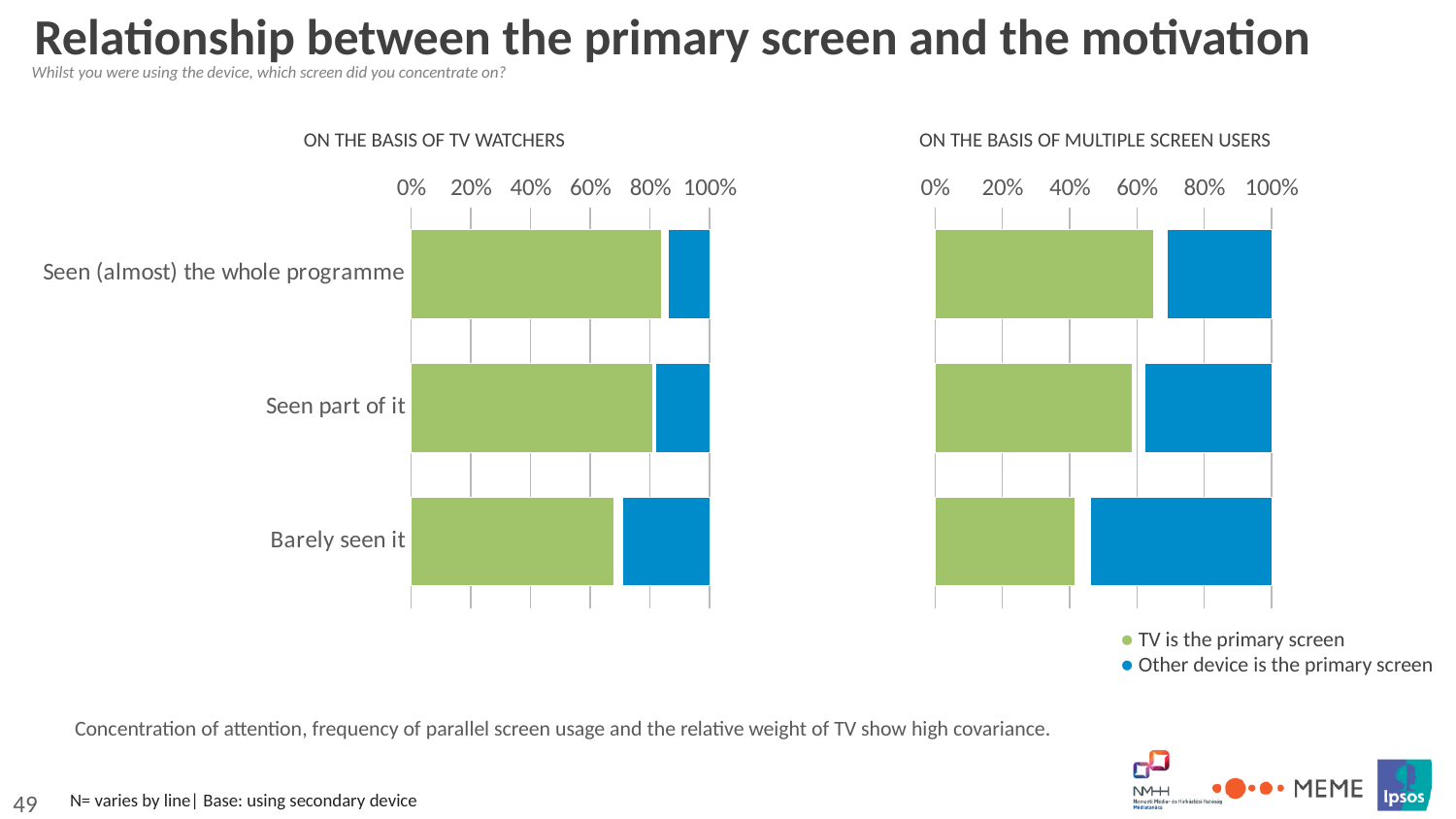
In the 'ON THE BASIS OF TV WATCHERS' chart, is the 'TV is the primary screen' value for 'Seen (almost) the whole programme' greater or less than 60%? greater What kind of chart is used on the slide for 'ON THE BASIS OF TV WATCHERS'? Stacked bar chart Which colour represents 'TV is the primary screen' in the legend? Green In the 'ON THE BASIS OF TV WATCHERS' chart, which category has the smallest 'TV is the primary screen' share? Barely seen it How many series does the legend list for the charts? 2 In the 'ON THE BASIS OF TV WATCHERS' chart, is the 'TV is the primary screen' value for 'Barely seen it' greater or less than 80%? less In the 'ON THE BASIS OF MULTIPLE SCREEN USERS' chart, does the 'TV is the primary screen' share rise or fall going from 'Seen (almost) the whole programme' down to 'Barely seen it'? fall In the 'ON THE BASIS OF MULTIPLE SCREEN USERS' chart, is the 'TV is the primary screen' value for 'Barely seen it' greater or less than 60%? less For 'Barely seen it', is the 'TV is the primary screen' share larger in the 'ON THE BASIS OF TV WATCHERS' chart or in the 'ON THE BASIS OF MULTIPLE SCREEN USERS' chart? ON THE BASIS OF TV WATCHERS In the 'ON THE BASIS OF MULTIPLE SCREEN USERS' chart, which category has the largest 'TV is the primary screen' share? Seen (almost) the whole programme How many categories are shown on the 'ON THE BASIS OF TV WATCHERS' chart? 3